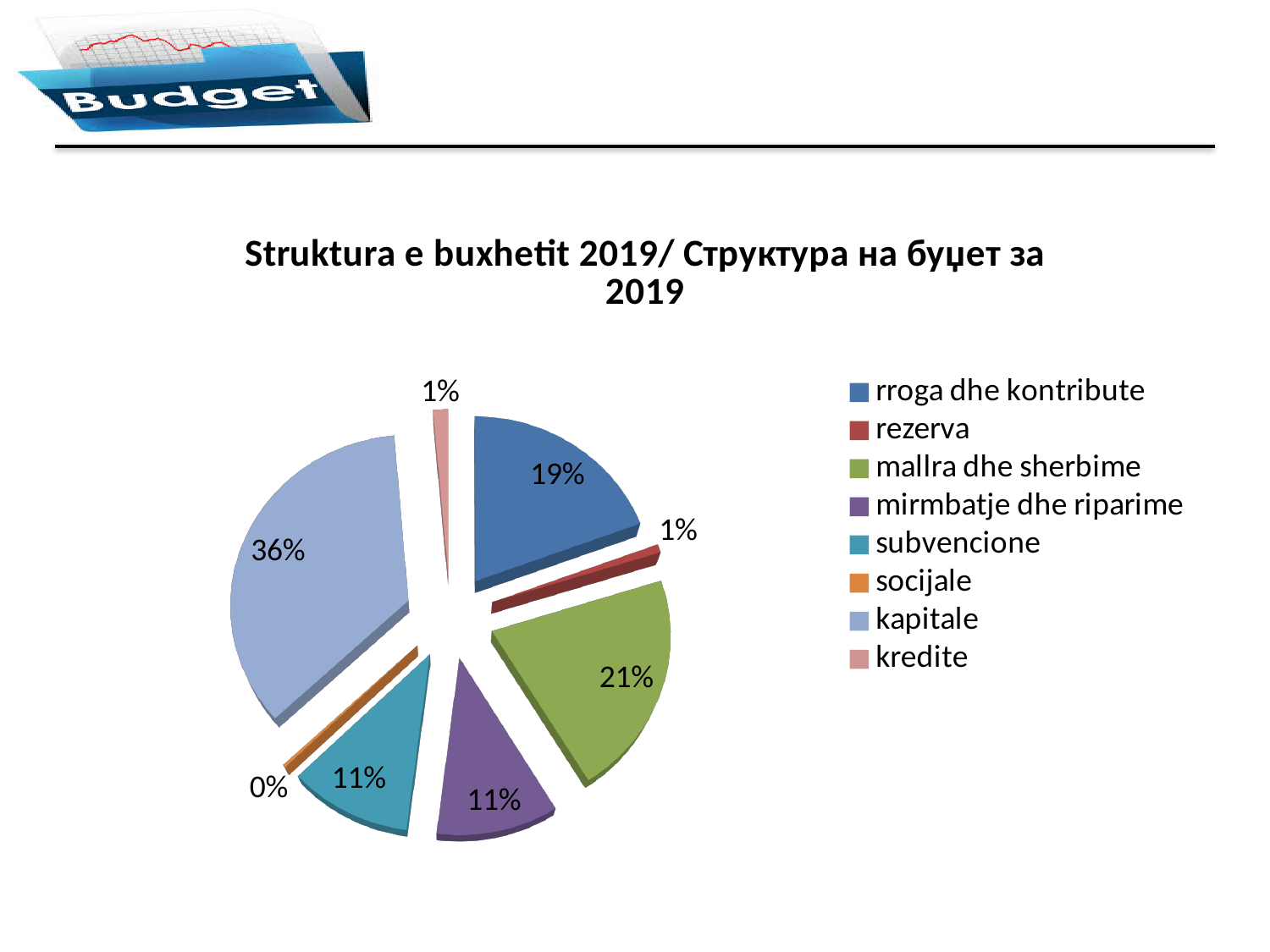
What is the title of the chart? Struktura e buxhetit 2019/ Структура на буџет за 2019 What is the difference in share between kapitale and mallra dhe sherbime? 15% How many categories does the legend list? 8 What share of the 2019 budget is socijale? 0% What share of the 2019 budget is rroga dhe kontribute? 19% Which has a larger share, rroga dhe kontribute or mallra dhe sherbime? mallra dhe sherbime What share of the 2019 budget is subvencione? 11% What kind of chart is shown on the slide? pie chart Which category has the smallest share of the 2019 budget? socijale Which category has the largest share of the 2019 budget? kapitale